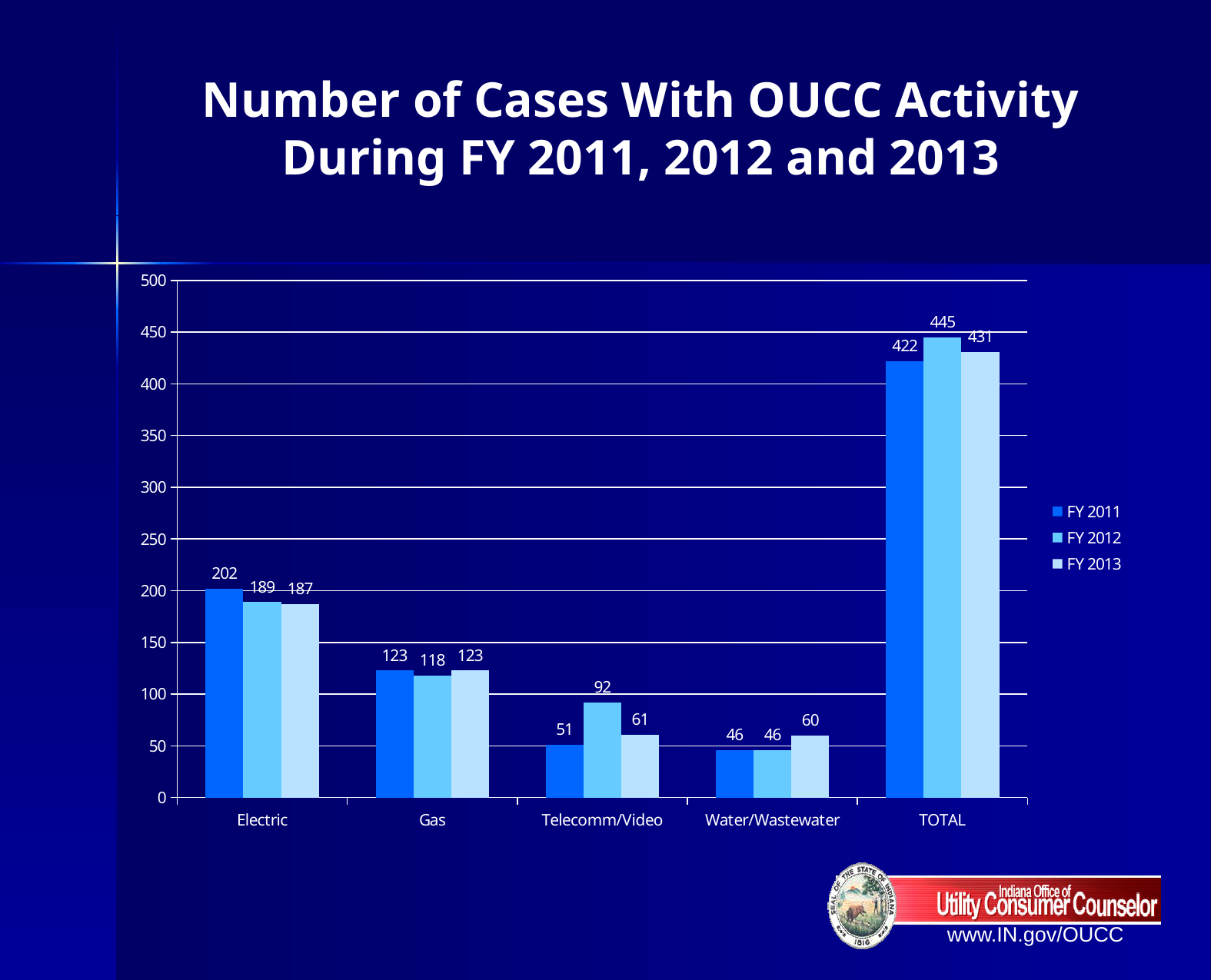
What kind of chart is shown on the slide? Bar chart What is the value for Electric in FY 2011? 202 What is the TOTAL value for FY 2013? 431 Is the FY 2011 value for Gas greater or less than 100? greater Which category has the lowest value in FY 2011? Water/Wastewater What is the difference between the FY 2012 and FY 2011 TOTAL values? 23 Which is larger: the FY 2012 value for Telecomm/Video or the FY 2013 value for Telecomm/Video? FY 2012 Excluding TOTAL, which category has the highest value in FY 2013? Electric What is the title of the chart? Number of Cases With OUCC Activity During FY 2011, 2012 and 2013 What is the value for Telecomm/Video in FY 2012? 92 How many categories are shown on the x axis? 5 How many series does the legend list? 3